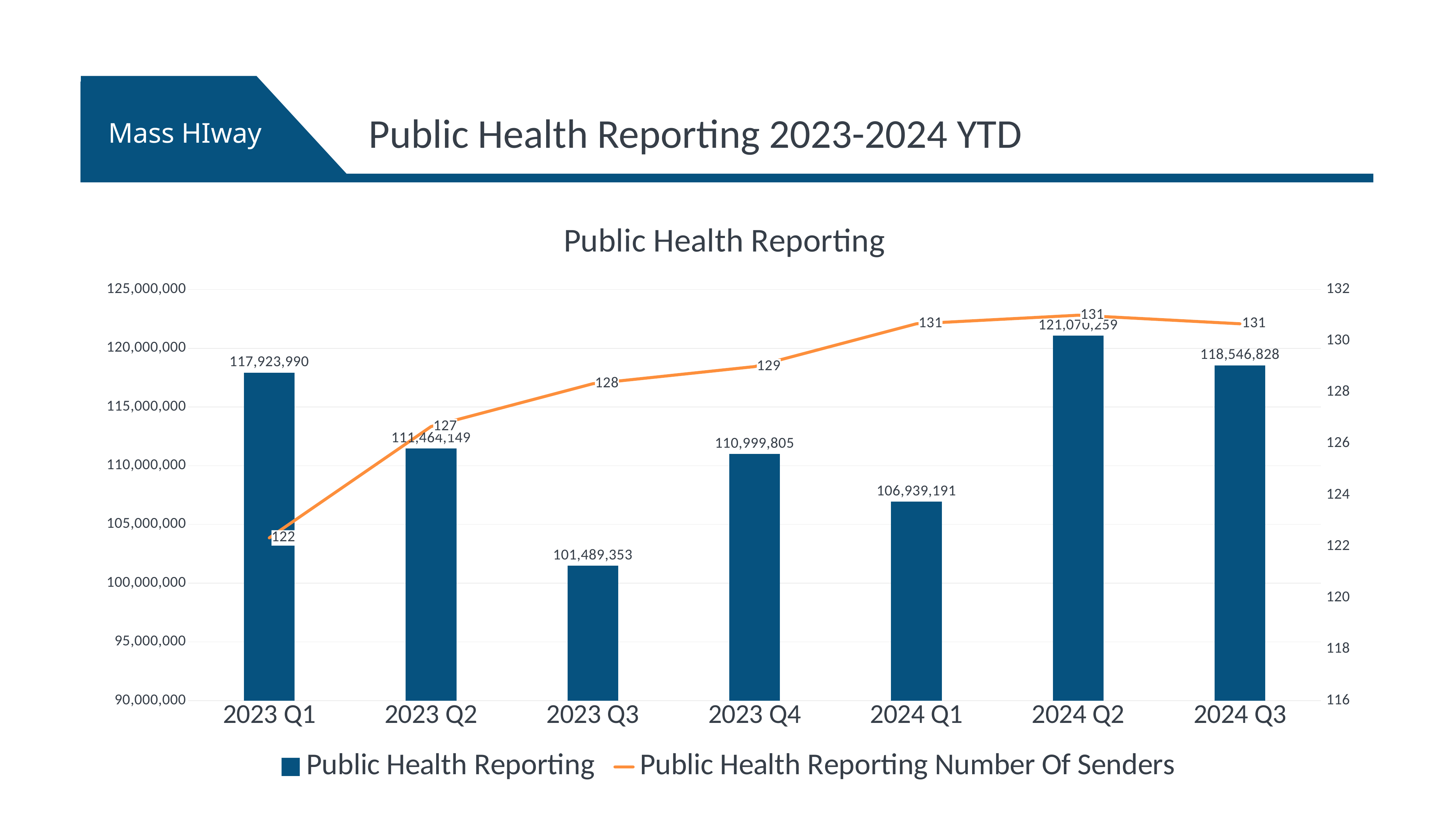
Is the Public Health Reporting value for 2024 Q2 greater or less than 120,000,000? greater Which quarter has the highest Public Health Reporting value? 2024 Q2 What is the value of Public Health Reporting for 2023 Q3? 101,489,353 Which quarter has the lowest Public Health Reporting value? 2023 Q3 Does the Public Health Reporting Number Of Senders line rise or fall from 2023 Q1 to 2024 Q1? rise What is the value of Public Health Reporting for 2023 Q1? 117,923,990 How many series does the legend list? 2 How many quarters are shown on the x axis? 7 What is the difference between the Public Health Reporting values for 2023 Q1 and 2023 Q2? 6,459,841 What is the Public Health Reporting Number Of Senders for 2024 Q1? 131 Which is larger, the Public Health Reporting value for 2023 Q4 or for 2024 Q1? 2023 Q4 What is the Public Health Reporting Number Of Senders for 2023 Q2? 127